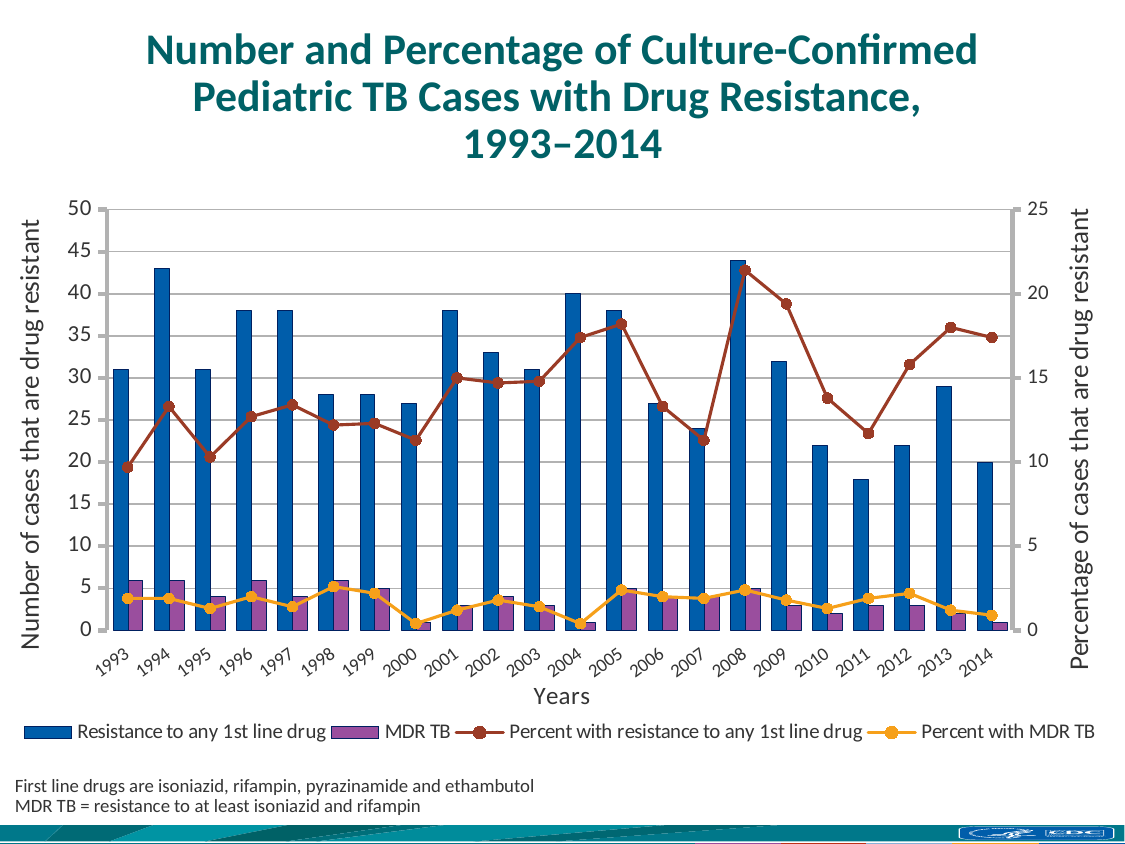
Does the Percent with resistance to any 1st line drug line rise or fall from 2011 to 2013? Rise How many series does the legend list? 4 Is the value for Resistance to any 1st line drug in 2000 greater or less than 30? less What is the title of the x axis? Years Which year has the lowest bar for Resistance to any 1st line drug? 2011 Which is larger, the Resistance to any 1st line drug bar for 2004 or for 2010? 2004 How many years are shown along the x axis? 22 Is the value for Resistance to any 1st line drug in 1994 greater or less than 40? greater What kind of chart is shown on the slide? A combined bar and line chart Is the Percent with resistance to any 1st line drug in 2008 greater or less than 20 on the right axis? greater